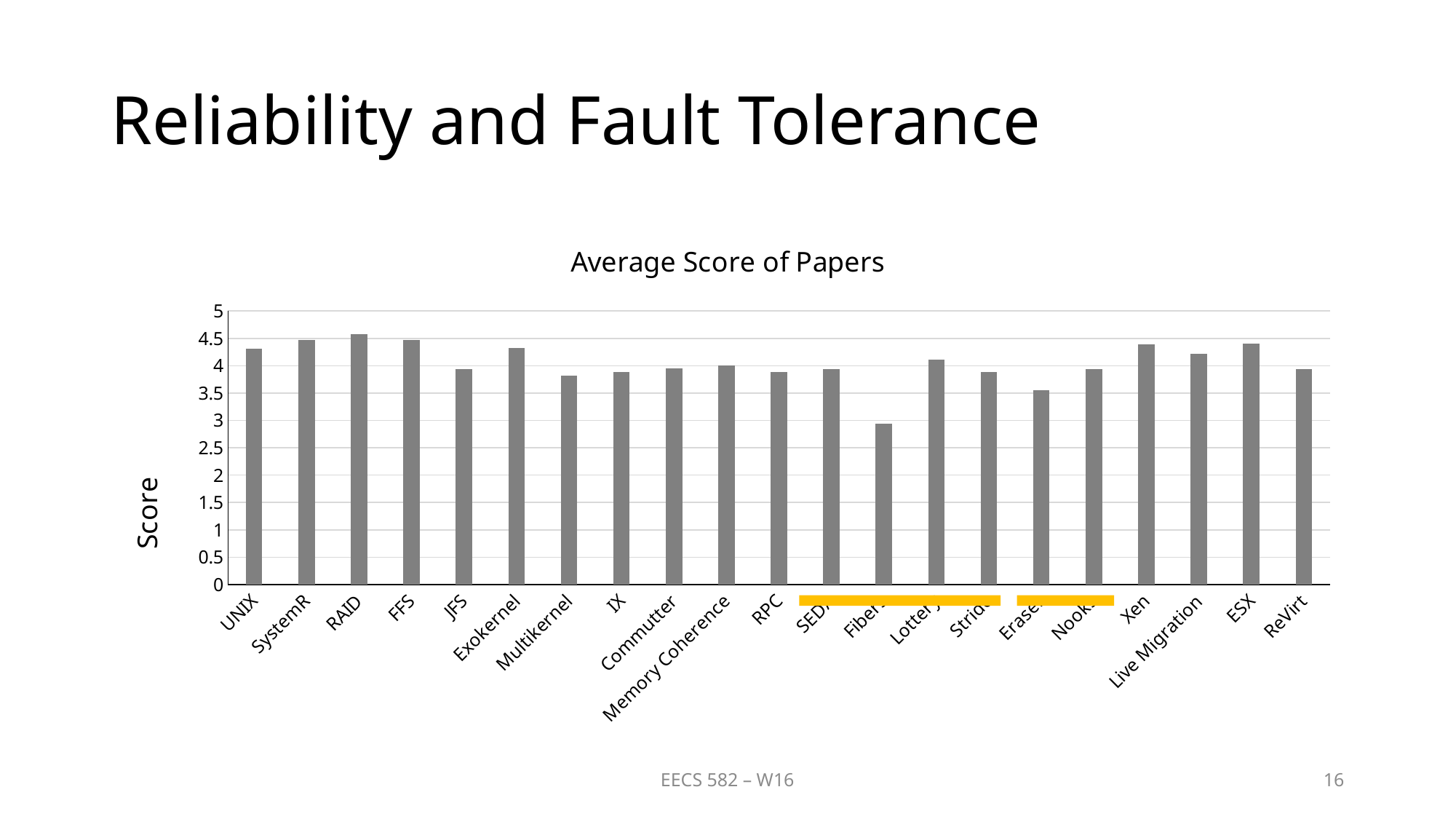
Which category has the highest average score? RAID What is the label on the vertical axis of the chart? Score What is the title of the chart? Average Score of Papers What kind of chart is shown on the slide? bar chart How many bars are plotted in the chart? 21 Is the value for RAID greater or less than 4.5? greater Which has the larger average score, ESX or JFS? ESX Is the value for Xen greater or less than 4? greater Which has the larger average score, RAID or Multikernel? RAID Is the value for Exokernel greater or less than 4? greater